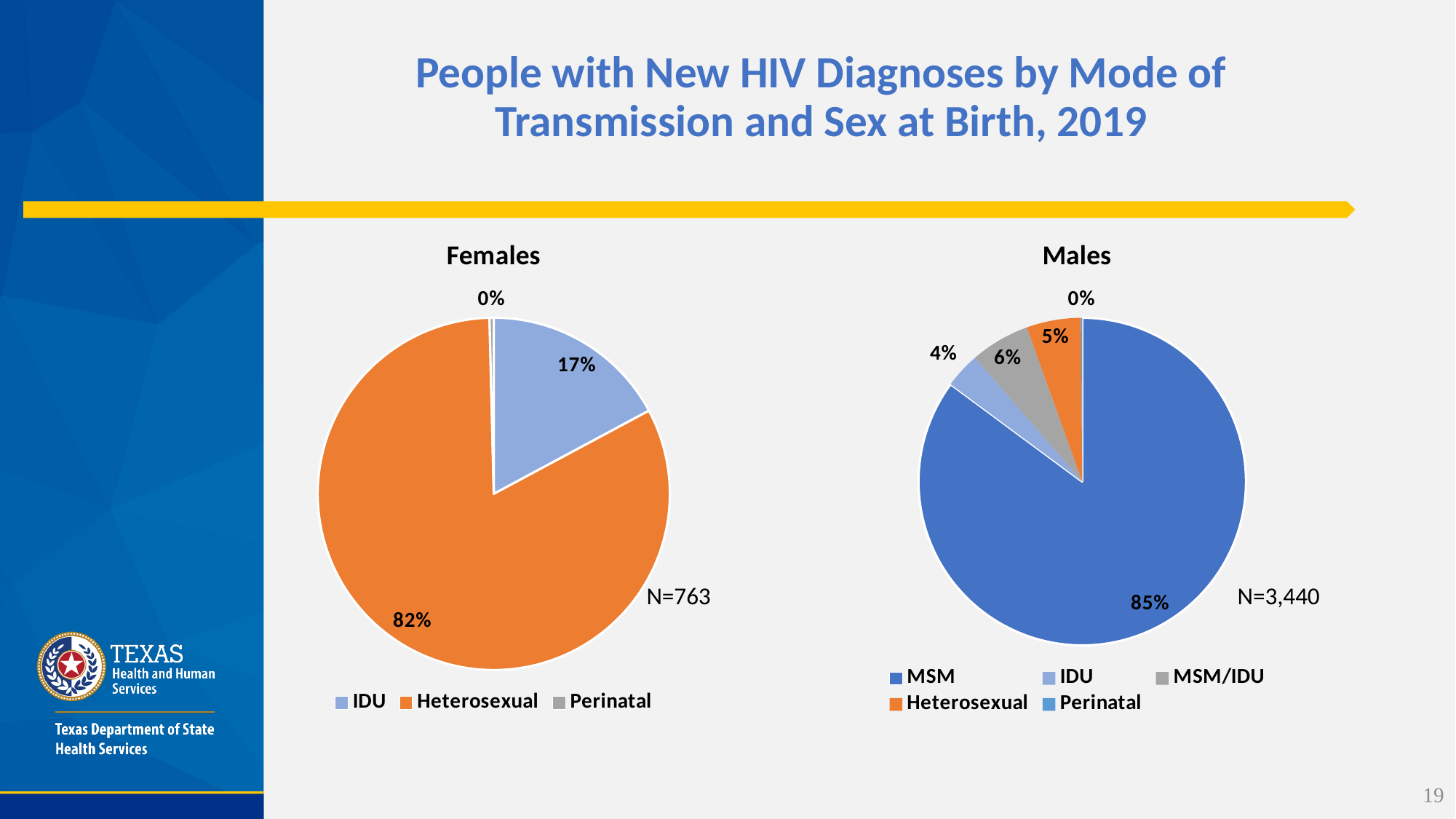
In the Males pie chart, what share of new HIV diagnoses is attributed to MSM? 85% In the Males pie chart, which mode of transmission has the largest share? MSM In the Males pie chart, what share of new HIV diagnoses is attributed to IDU? 4% In the Males pie chart, which is larger: the share for MSM/IDU or the share for IDU? MSM/IDU In the Females pie chart, which mode of transmission has the largest share? Heterosexual In the Males pie chart, what share of new HIV diagnoses is attributed to Heterosexual transmission? 5% In the Males pie chart, what is the difference in percentage points between the MSM share and the MSM/IDU share? 79 percentage points How many entries does the legend of the Males pie chart list? 5 What is the N value shown next to the Females pie chart? N=763